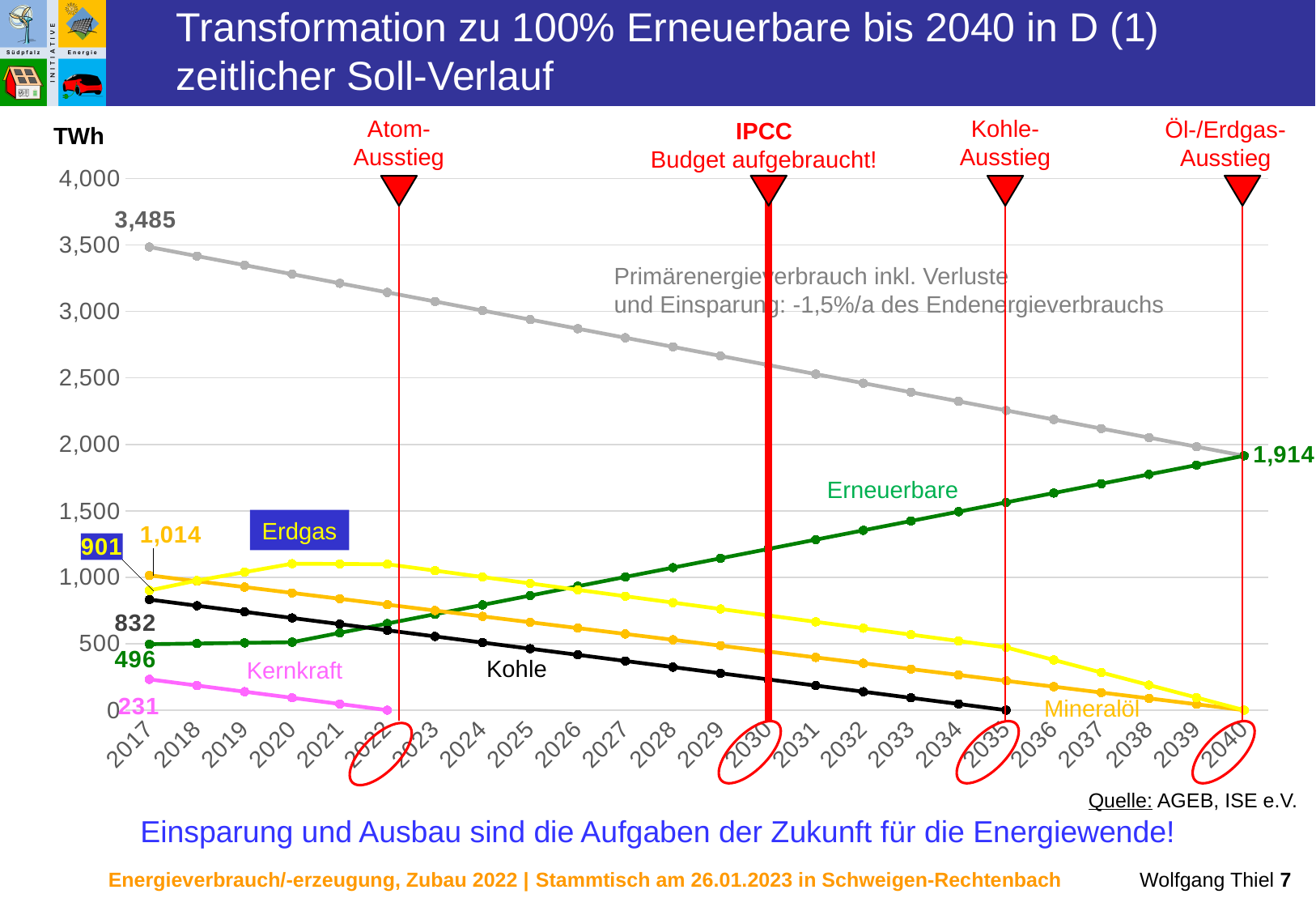
What kind of chart is shown on the slide? line chart Which series has the highest value in 2017? Primärenergieverbrauch Is the value for Erneuerbare in 2030 greater or less than 1,000? greater What is the value for Erneuerbare in 2017? 496 Does the Primärenergieverbrauch line rise or fall from 2017 to 2040? fall What unit is shown on the y axis? TWh What value does the Erneuerbare line reach in 2040? 1,914 What is the value for Kohle in 2017? 832 What is the value of Primärenergieverbrauch in 2017? 3,485 What is the value for Kernkraft in 2017? 231 In 2017, which is larger: Mineralöl or Kohle? Mineralöl By how much does the Erneuerbare value increase from 2017 to 2040? 1,418